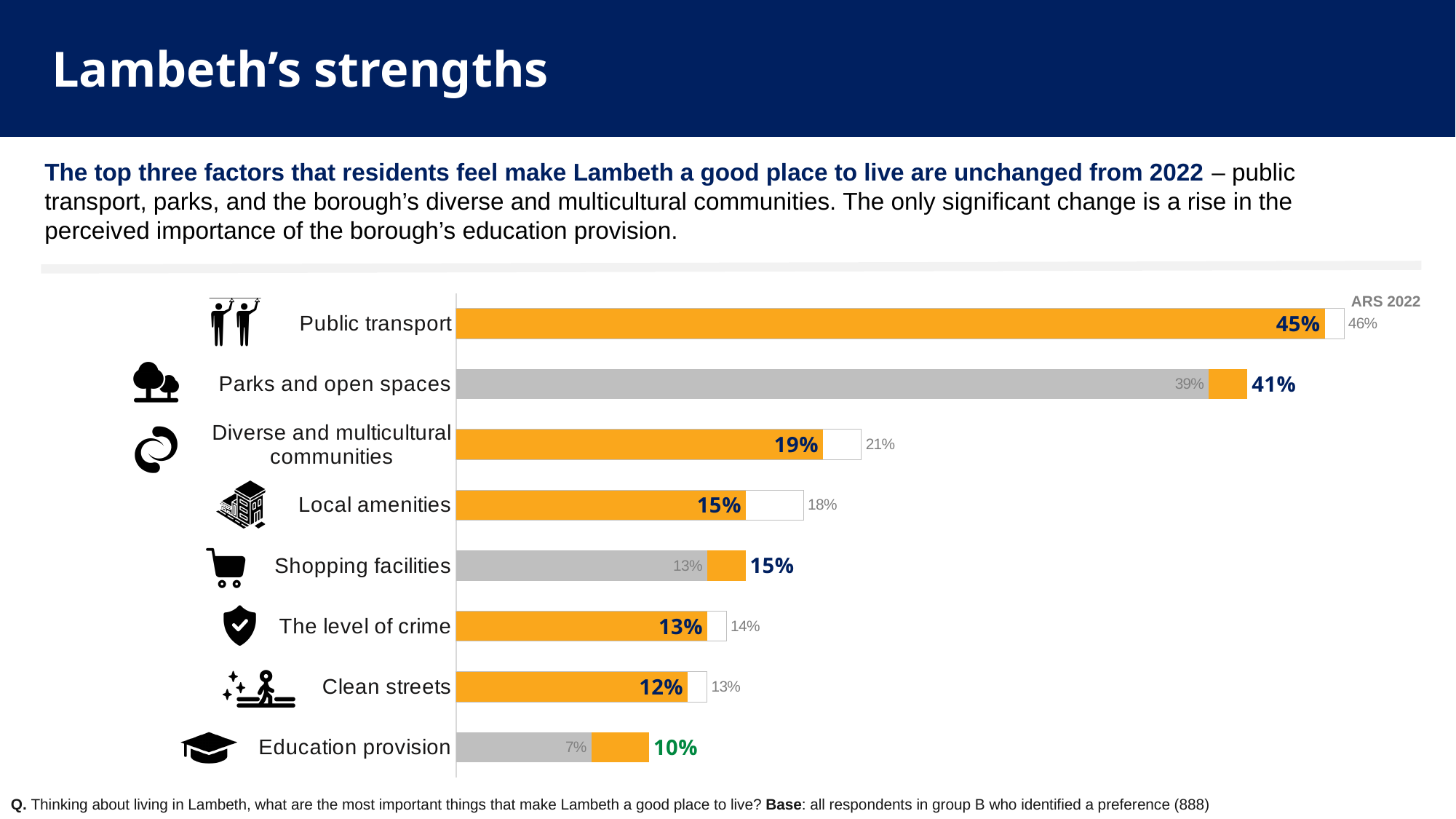
Which is larger: the current value for Local amenities or the current value for The level of crime? Local amenities What kind of chart is shown on the slide? Bar chart Which factor has the lowest current value? Education provision By how many percentage points did Education provision rise from ARS 2022 to the current value? 3 percentage points Which factor has the highest current value? Public transport What is the current value for Parks and open spaces? 41% What is the ARS 2022 value for Diverse and multicultural communities? 21% What percentage of residents chose Public transport as a factor that makes Lambeth a good place to live? 45% What was the ARS 2022 value for Education provision? 7% How many factors are shown in the chart? 8 What is the label of the comparison series shown in grey next to the current values? ARS 2022 What is the difference between the current value for Public transport and the current value for Parks and open spaces? 4 percentage points